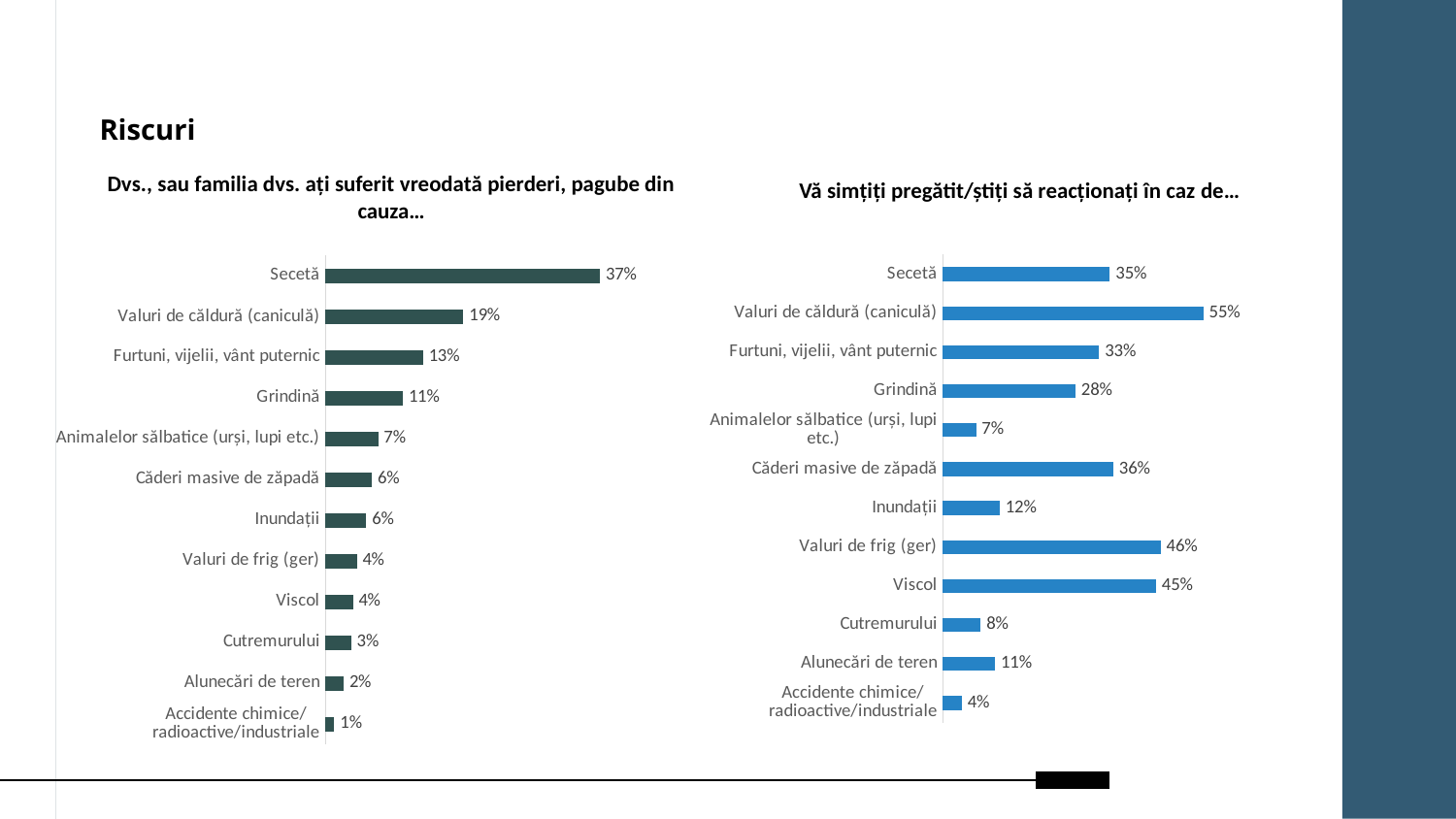
In the right chart ("Vă simțiți pregătit/știți să reacționați în caz de…"), which category has the highest value? Valuri de căldură (caniculă) In the left chart ("Dvs., sau familia dvs. ați suferit vreodată pierderi, pagube din cauza…"), what is the value for Cutremurului? 3% In the right chart ("Vă simțiți pregătit/știți să reacționați în caz de…"), which is larger: the value for Inundații or the value for Grindină? Grindină In the left chart ("Dvs., sau familia dvs. ați suferit vreodată pierderi, pagube din cauza…"), which is larger: the value for Grindină or the value for Furtuni, vijelii, vânt puternic? Furtuni, vijelii, vânt puternic How many categories are shown in the left chart ("Dvs., sau familia dvs. ați suferit vreodată pierderi, pagube din cauza…")? 12 In the right chart ("Vă simțiți pregătit/știți să reacționați în caz de…"), what is the value for Valuri de frig (ger)? 46% In the left chart ("Dvs., sau familia dvs. ați suferit vreodată pierderi, pagube din cauza…"), what is the value for Secetă? 37% In the right chart ("Vă simțiți pregătit/știți să reacționați în caz de…"), what is the value for Căderi masive de zăpadă? 36% In the left chart ("Dvs., sau familia dvs. ați suferit vreodată pierderi, pagube din cauza…"), what is the difference between the values for Secetă and Valuri de căldură (caniculă)? 18% In the right chart ("Vă simțiți pregătit/știți să reacționați în caz de…"), what is the difference between the values for Valuri de căldură (caniculă) and Secetă? 20% In the left chart ("Dvs., sau familia dvs. ați suferit vreodată pierderi, pagube din cauza…"), which category has the lowest value? Accidente chimice/radioactive/industriale What type of chart is the right chart ("Vă simțiți pregătit/știți să reacționați în caz de…")? Bar chart